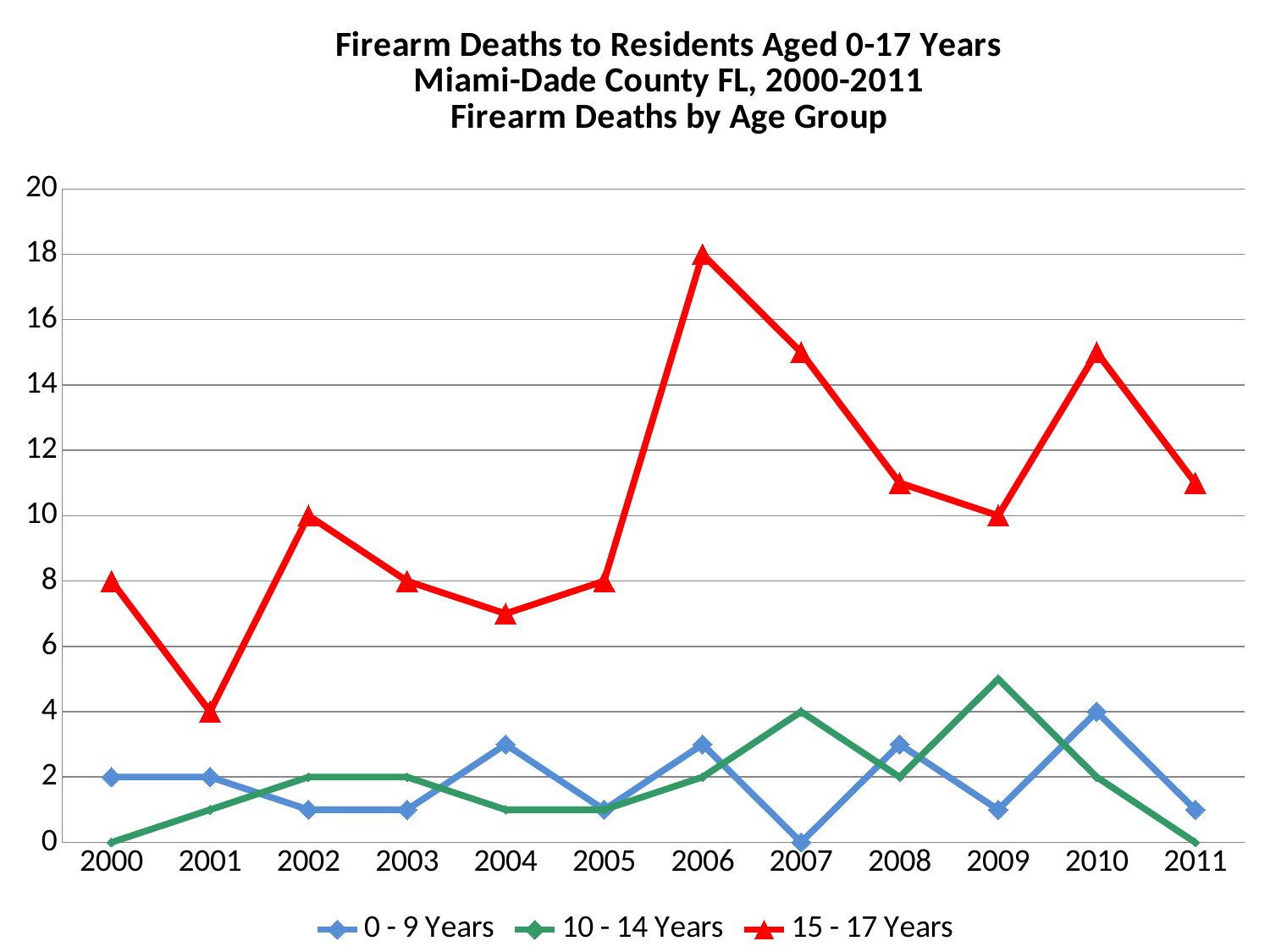
What is the difference between the 15 - 17 Years values in 2006 and 2001? 14 Does the 15 - 17 Years series rise or fall from 2006 to 2009? Fall How many years are plotted along the x axis? 12 What type of chart is shown on the slide? Line chart What is the value for the 0 - 9 Years series in 2010? 4 Is the value for the 15 - 17 Years series in 2007 greater or less than 14? greater In which year does the 15 - 17 Years series reach its highest value? 2006 In which year does the 10 - 14 Years series reach its highest value? 2009 How many series does the legend list? 3 Which series has the larger value in 2009, 0 - 9 Years or 10 - 14 Years? 10 - 14 Years What is the value for the 15 - 17 Years series in 2006? 18 What is the value for the 15 - 17 Years series in 2001? 4